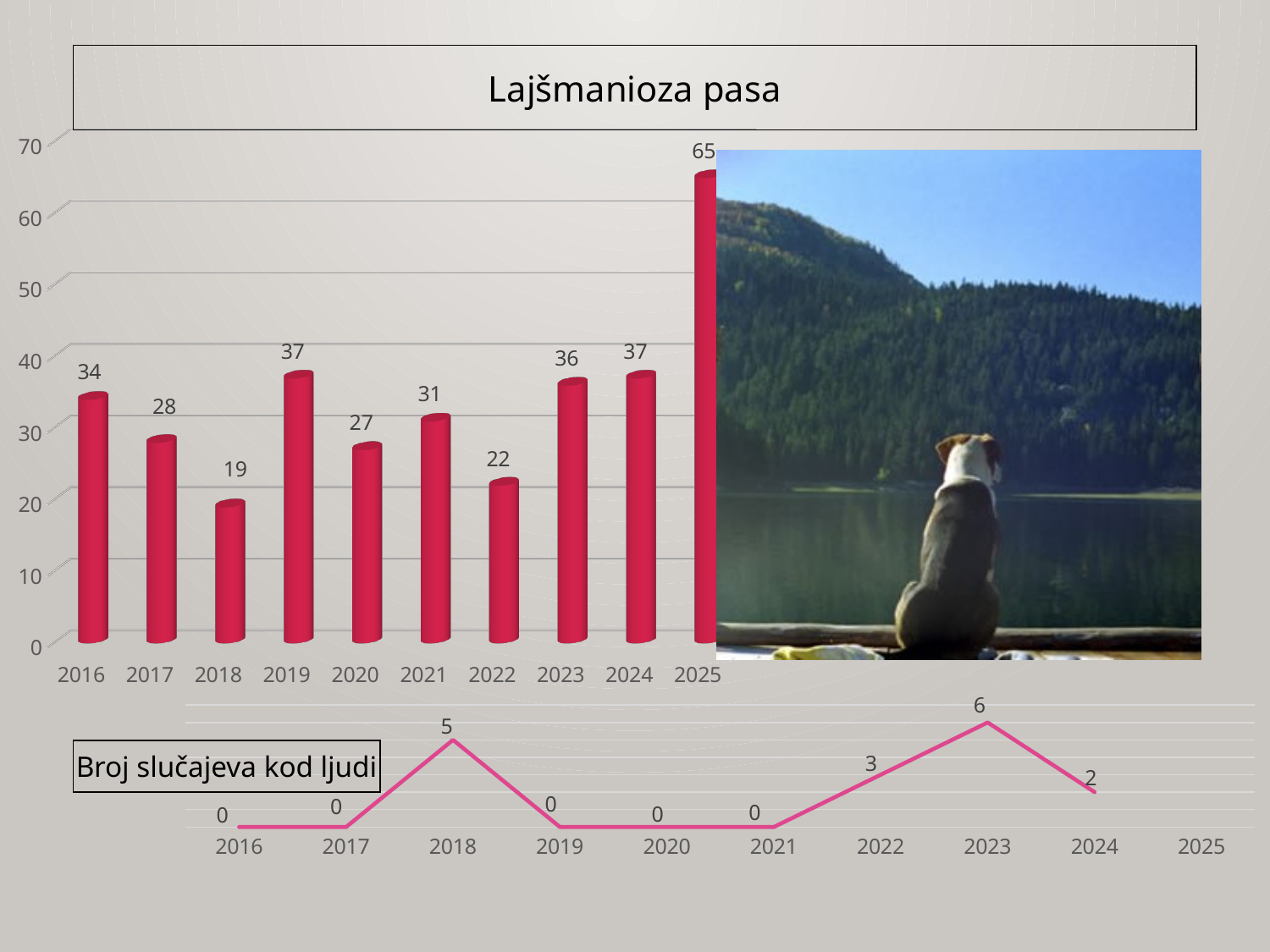
In the 'Lajšmanioza pasa' chart, what is the difference between the values for 2025 and 2024? 28 What kind of chart is the 'Lajšmanioza pasa' chart? bar chart In the 'Lajšmanioza pasa' chart, which year has the highest value? 2025 In the 'Lajšmanioza pasa' chart, which year has the lowest value? 2018 What kind of chart is the 'Broj slučajeva kod ljudi' chart? line chart In the 'Broj slučajeva kod ljudi' chart, what is the value for 2023? 6 In the 'Lajšmanioza pasa' chart, what is the value for 2018? 19 How many bars are plotted in the 'Lajšmanioza pasa' chart? 10 In the 'Broj slučajeva kod ljudi' chart, what is the value for 2018? 5 In the 'Lajšmanioza pasa' chart, what is the value for 2025? 65 In the 'Lajšmanioza pasa' chart, which is larger, the value for 2021 or the value for 2022? 2021 In the 'Broj slučajeva kod ljudi' chart, what is the difference between the values for 2023 and 2024? 4